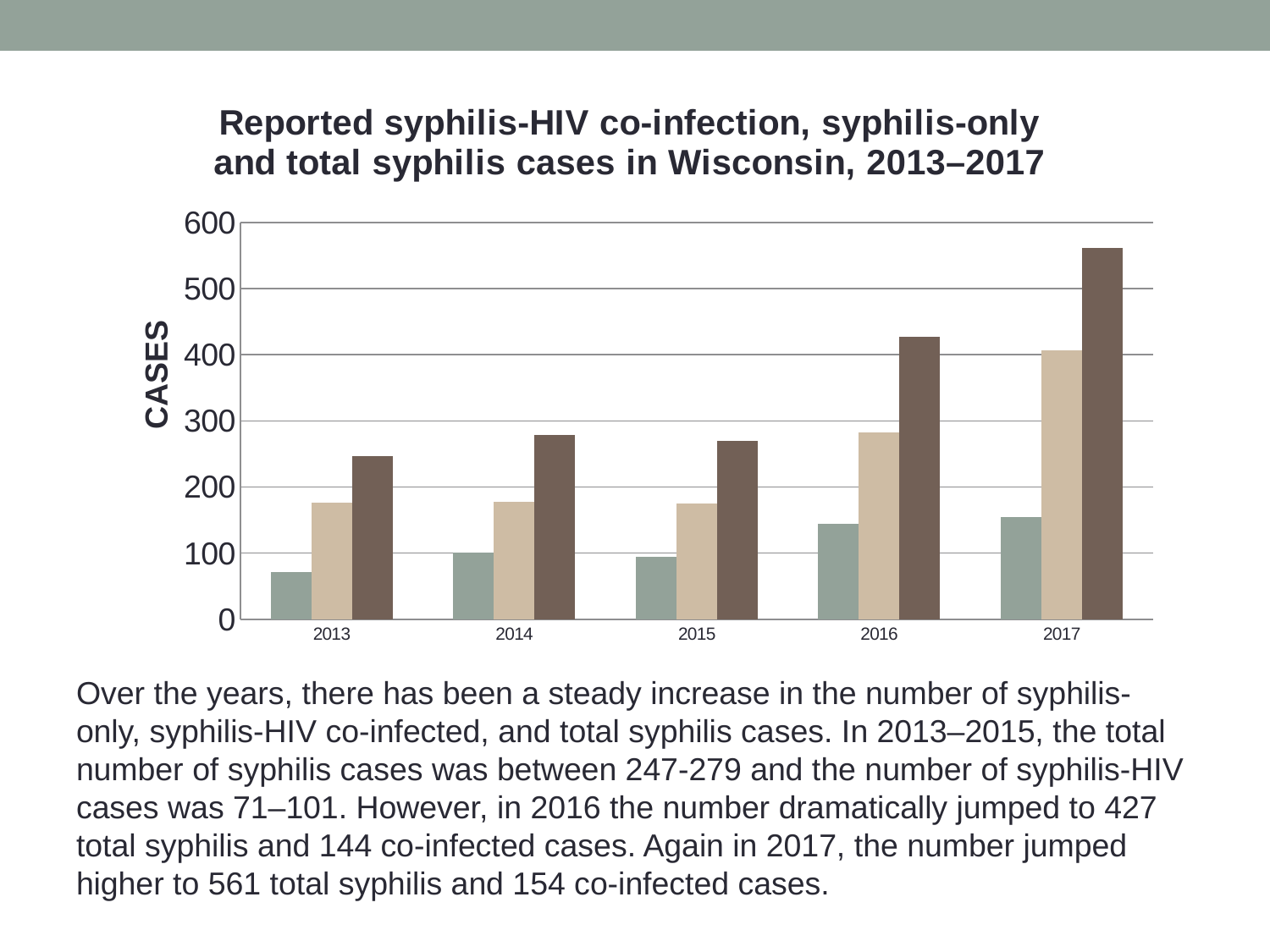
What kind of chart is shown on the slide? bar chart In which year is the dark brown bar the tallest? 2017 Which is larger, the dark brown bar for 2016 or the dark brown bar for 2015? 2016 Is the tan bar for 2016 greater or less than 300? less What is the label on the vertical axis of the chart? CASES In which year is the dark brown bar the shortest? 2013 How many bars are plotted for each year in the chart? 3 Is the dark brown bar for 2017 greater or less than 500? greater Is the green bar for 2013 greater or less than 100? less What is the title of the chart? Reported syphilis-HIV co-infection, syphilis-only and total syphilis cases in Wisconsin, 2013–2017 How many years are shown on the x axis of the chart? 5 In which year is the green bar the shortest? 2013